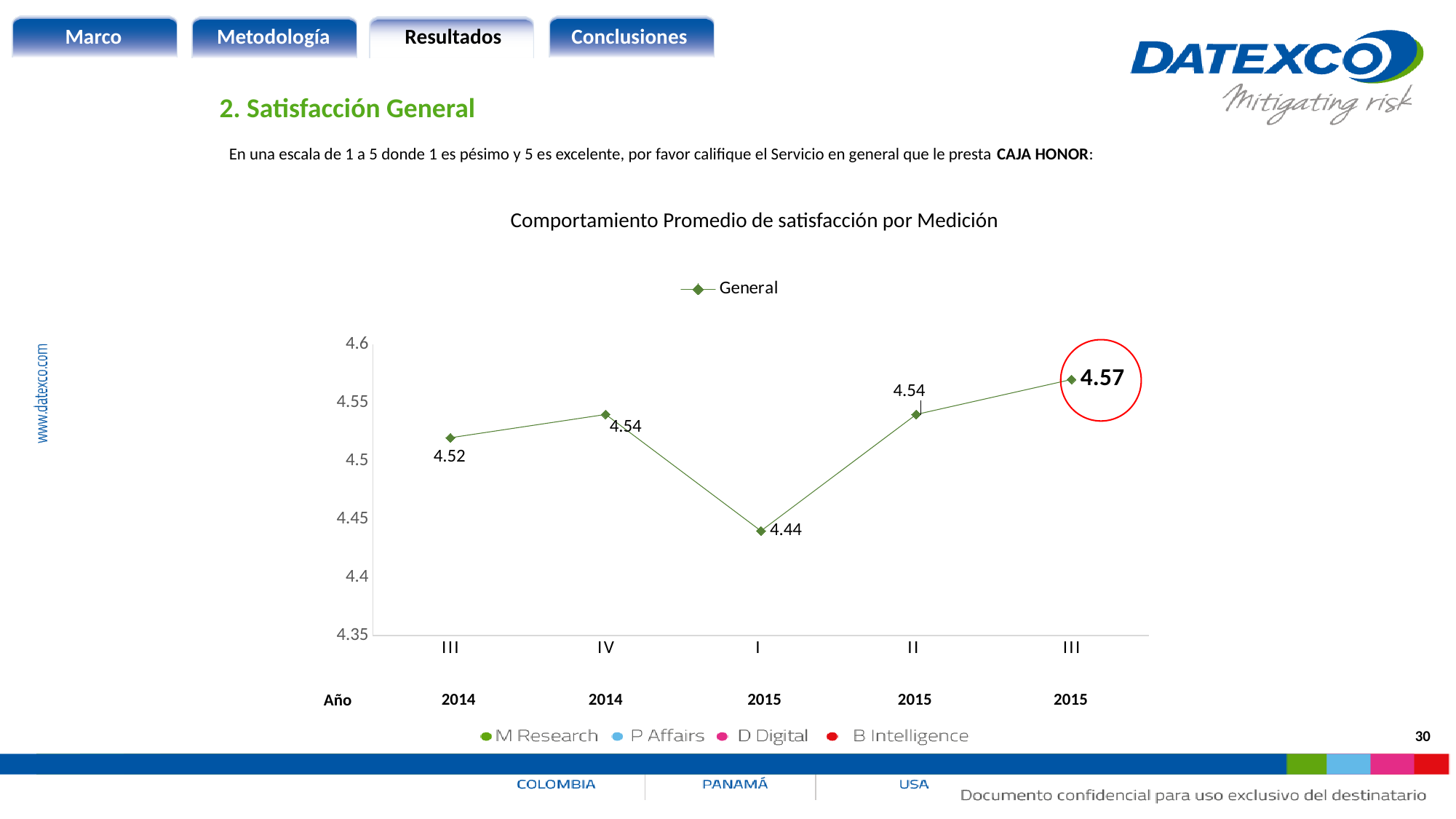
Which measurement period has the lowest value? I 2015 What is the title of the chart? Comportamiento Promedio de satisfacción por Medición Which measurement period has the highest value? III 2015 What is the value for IV 2014? 4.54 What type of chart is shown on the slide? line chart What is the difference between the values for III 2015 and I 2015? 0.13 How many series does the chart legend list? 1 What is the value for III 2014? 4.52 What is the value for I 2015? 4.44 Which is larger, the value for III 2014 or the value for II 2015? II 2015 What is the value for III 2015? 4.57 How many data points are plotted on the line? 5